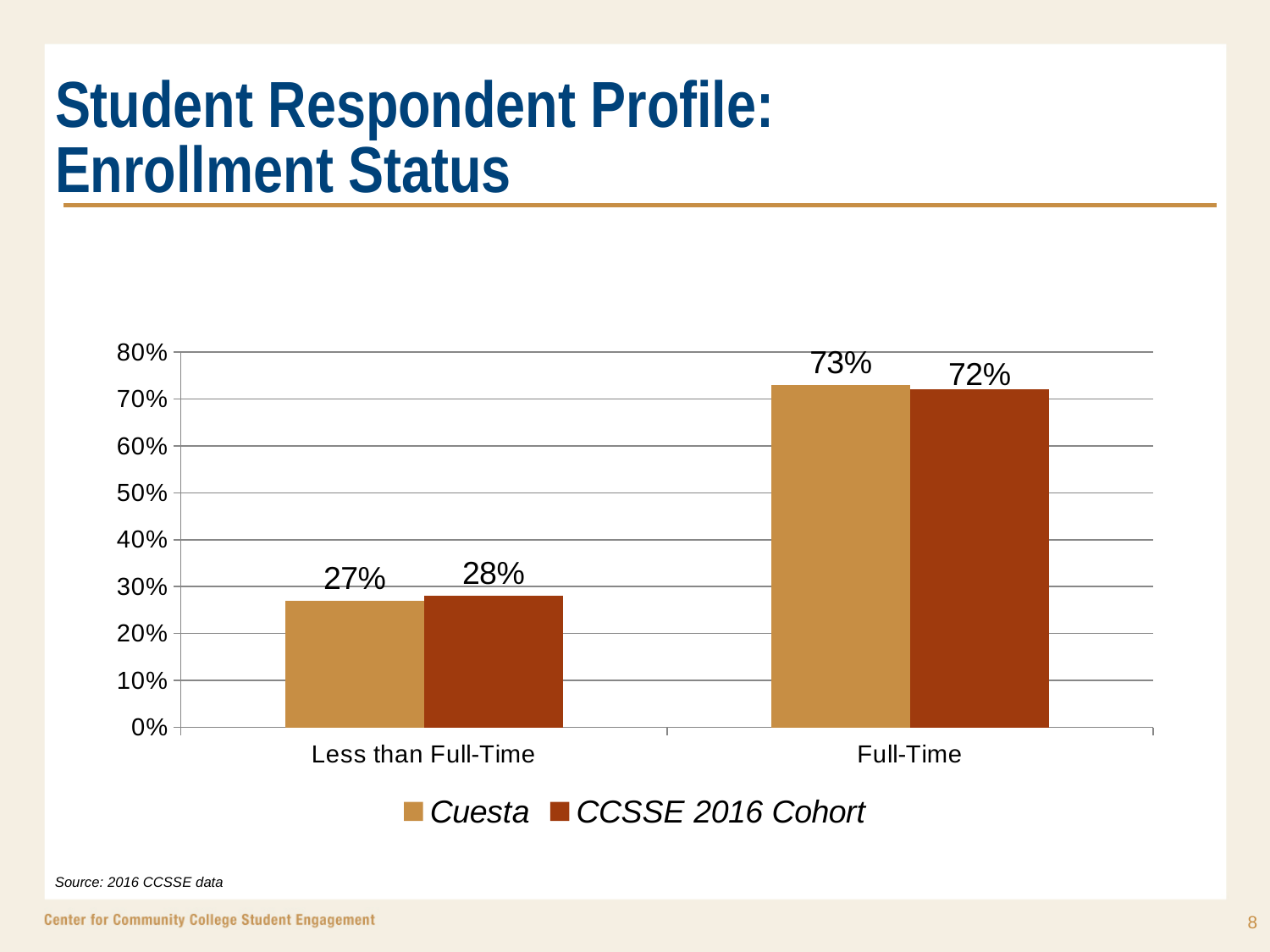
What is the CCSSE 2016 Cohort value for Less than Full-Time? 28% What is the CCSSE 2016 Cohort value for Full-Time? 72% What is the difference between the Cuesta values for Full-Time and Less than Full-Time? 46% How many categories are shown on the x axis? 2 How many series does the legend list? 2 What is the Cuesta value for Less than Full-Time? 27% Which enrollment status category has the highest Cuesta value? Full-Time What is the difference between the Cuesta and CCSSE 2016 Cohort values for Less than Full-Time? 1% What is the Cuesta value for Full-Time? 73% What kind of chart is shown on the slide? Bar chart Which enrollment status category has the lowest CCSSE 2016 Cohort value? Less than Full-Time Is the Cuesta value for Full-Time greater or less than 50%? greater